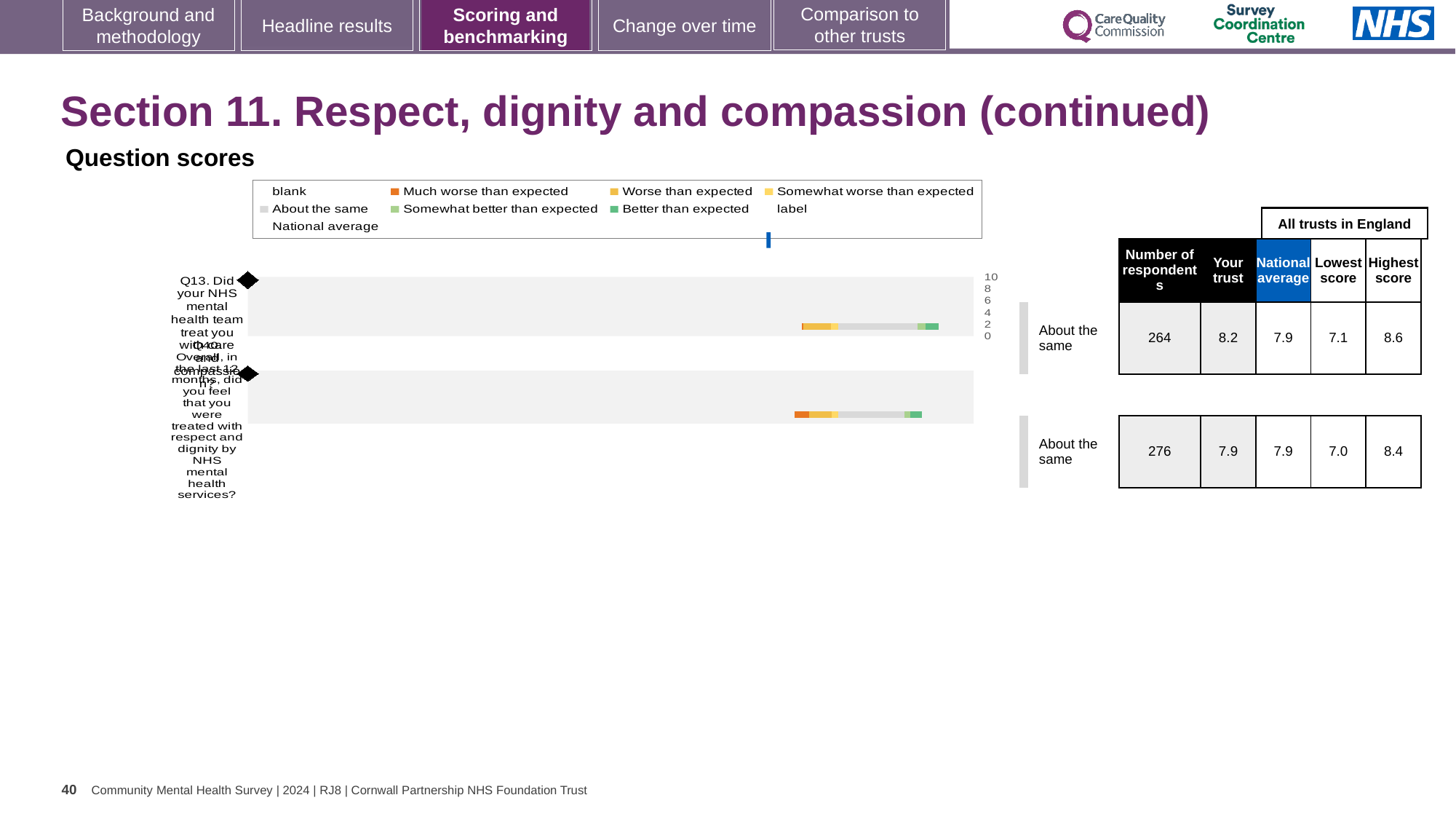
How many questions are plotted on the chart? 2 What is the 'Your trust' score for Q14 (treated with respect and dignity)? 7.9 What is the difference between the highest and lowest scores for Q14? 1.4 What is the 'Your trust' score for Q13 (care and compassion)? 8.2 What is the lowest score among all trusts in England for Q14? 7.0 What type of chart is shown on the slide? Bar chart What is the national average score for Q13? 7.9 What is the highest score among all trusts in England for Q13? 8.6 Which question has the higher 'Your trust' score, Q13 or Q14? Q13 What benchmark category is shown for both Q13 and Q14? About the same What is the difference between the trust's score and the national average for Q13? 0.3 How many respondents answered Q14? 276